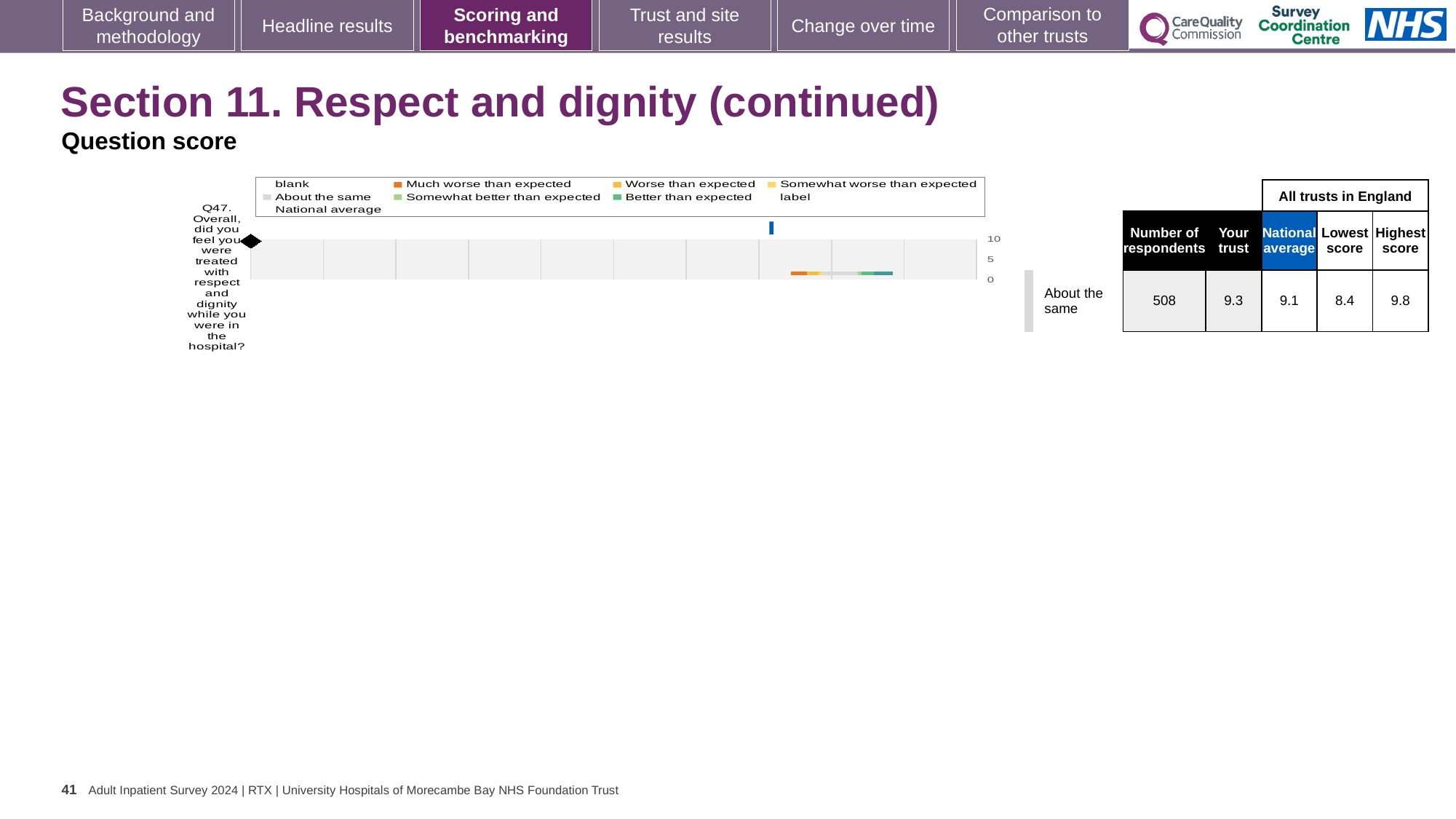
According to the table next to the chart, what is the Highest score among all trusts in England for Q47? 9.8 Which question number is plotted on the chart? Q47 According to the table next to the chart, how many respondents answered Q47? 508 What is the difference between the Highest score and the Lowest score for Q47 in the table? 1.4 How many questions are plotted on the chart? 1 What is the maximum value shown on the chart's axis? 10 According to the table next to the chart, what is the National average score for Q47? 9.1 What kind of chart is shown on the slide? bar chart Which is larger for Q47, the Your trust score or the National average score? Your trust Is the national average marker on the chart greater or less than 5? greater According to the table next to the chart, what is the Lowest score among all trusts in England for Q47? 8.4 According to the table next to the chart, what is the score for Your trust on Q47? 9.3